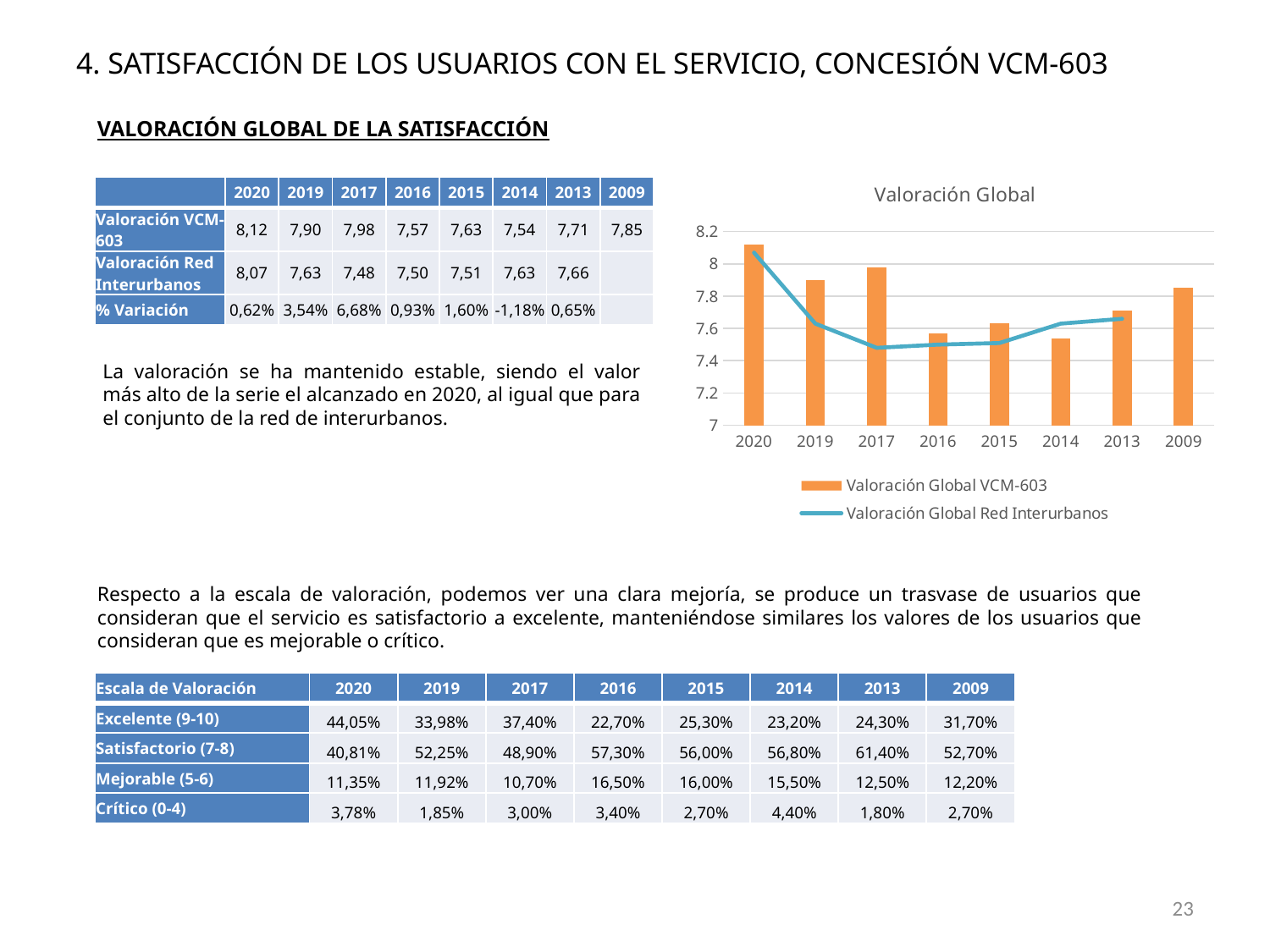
In the 'Valoración Global' chart, which is larger: the VCM-603 bar for 2020 or for 2019? 2020 According to the slide, what is the Valoración Red Interurbanos value for 2013? 7,66 According to the slide, what is the Valoración VCM-603 value for 2020? 8,12 In the 'Valoración Global' chart, does the Valoración Global Red Interurbanos line rise or fall from 2020 to 2017? fall In the 'Valoración Global' chart, is the Valoración Global Red Interurbanos value for 2017 greater or less than 7.6? less How many years are shown on the x axis of the 'Valoración Global' chart? 8 In the 'Valoración Global' chart, is the Valoración Global VCM-603 bar for 2020 greater or less than 8? greater What is the difference between the 2020 Valoración VCM-603 (8,12) and the 2020 Valoración Red Interurbanos (8,07)? 0,05 In the 'Valoración Global' chart, is the Valoración Global VCM-603 bar for 2014 greater or less than 7.6? less In the 'Valoración Global' chart, which year has the highest bar for Valoración Global VCM-603? 2020 What kind of chart is the 'Valoración Global' chart? bar and line chart How many series does the legend of the 'Valoración Global' chart list? 2